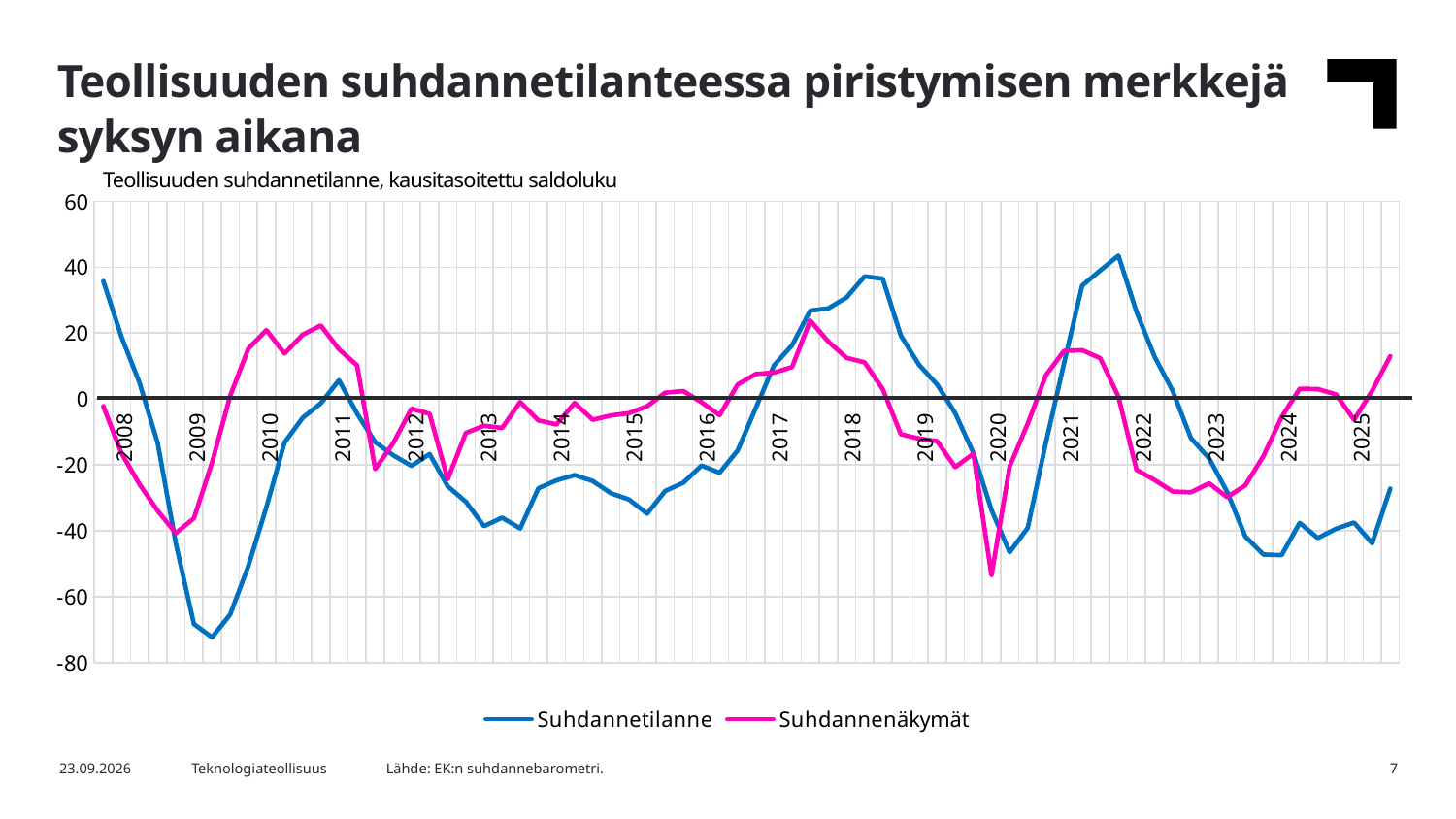
Is the lowest value of the Suhdannetilanne line, reached in 2009, greater or less than -60? less Is the peak of the Suhdannenäkymät line in 2010 greater or less than 0? greater What kind of chart is shown on the slide? Line chart Is the lowest value of the Suhdannenäkymät line, reached in 2020, greater or less than -40? less Does the Suhdannetilanne line rise or fall between its 2021 peak and 2023? fall How many year labels are shown on the x axis? 18 In which year does the Suhdannetilanne line reach its lowest point? 2009 What are the two series named in the legend? Suhdannetilanne and Suhdannenäkymät What is the subtitle printed above the chart? Teollisuuden suhdannetilanne, kausitasoitettu saldoluku How many series does the legend list? 2